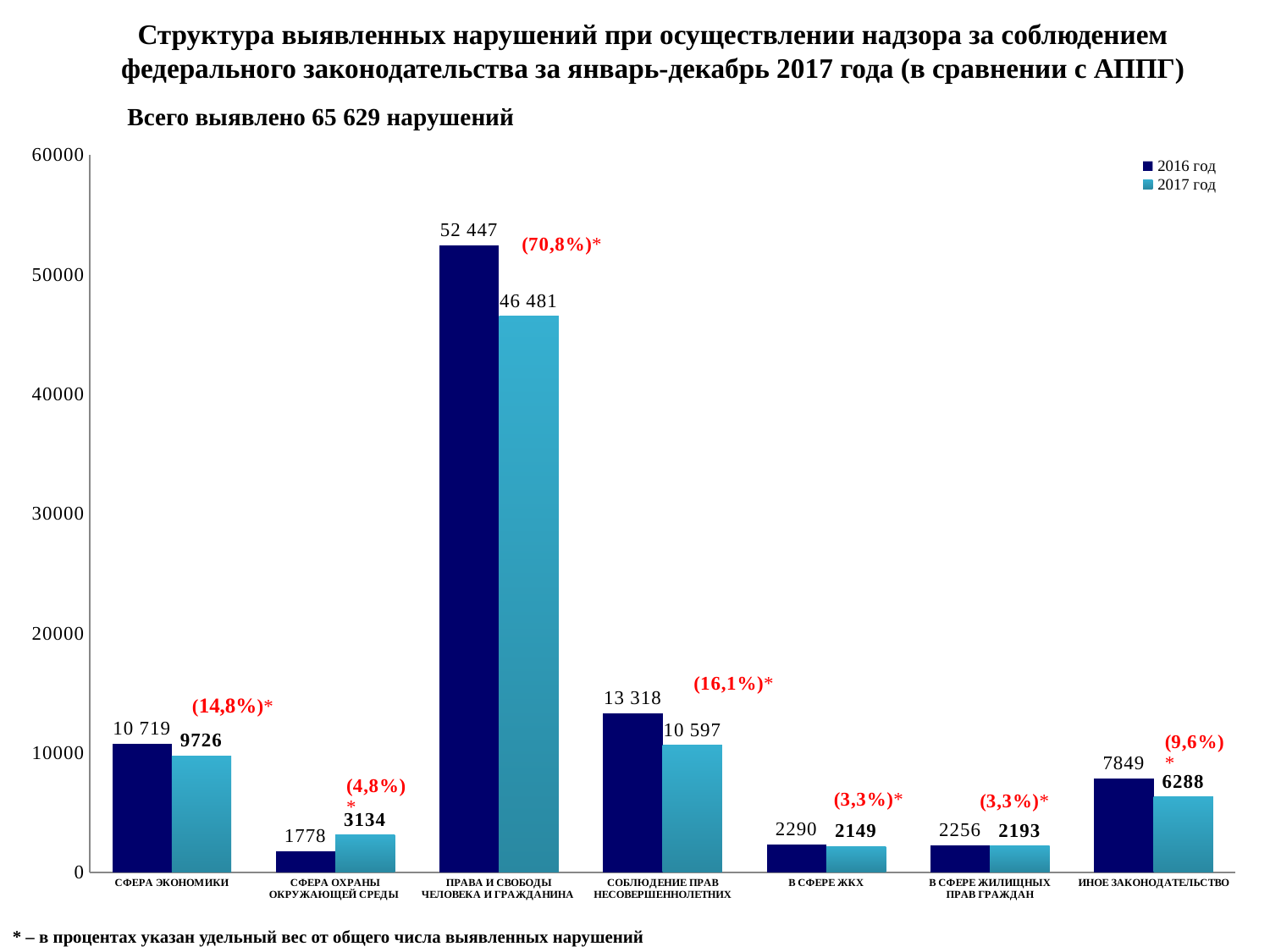
How many categories are shown on the x axis? 7 How many series does the legend list? 2 What is the 2017 год value for СФЕРА ОХРАНЫ ОКРУЖАЮЩЕЙ СРЕДЫ? 3134 Which is larger for СОБЛЮДЕНИЕ ПРАВ НЕСОВЕРШЕННОЛЕТНИХ: the 2016 год value or the 2017 год value? 2016 год Is the 2017 год value for ИНОЕ ЗАКОНОДАТЕЛЬСТВО greater or less than 10000? less Which category has the highest 2016 год value? ПРАВА И СВОБОДЫ ЧЕЛОВЕКА И ГРАЖДАНИНА Which category has the lowest 2016 год value? СФЕРА ОХРАНЫ ОКРУЖАЮЩЕЙ СРЕДЫ What kind of chart is shown on the slide? bar chart What is the 2016 год value for СФЕРА ЭКОНОМИКИ? 10 719 What is the difference between the 2017 год and 2016 год values for СФЕРА ОХРАНЫ ОКРУЖАЮЩЕЙ СРЕДЫ? 1356 What is the 2017 год value for ПРАВА И СВОБОДЫ ЧЕЛОВЕКА И ГРАЖДАНИНА? 46 481 What is the difference between the 2016 год and 2017 год values for ПРАВА И СВОБОДЫ ЧЕЛОВЕКА И ГРАЖДАНИНА? 5 966